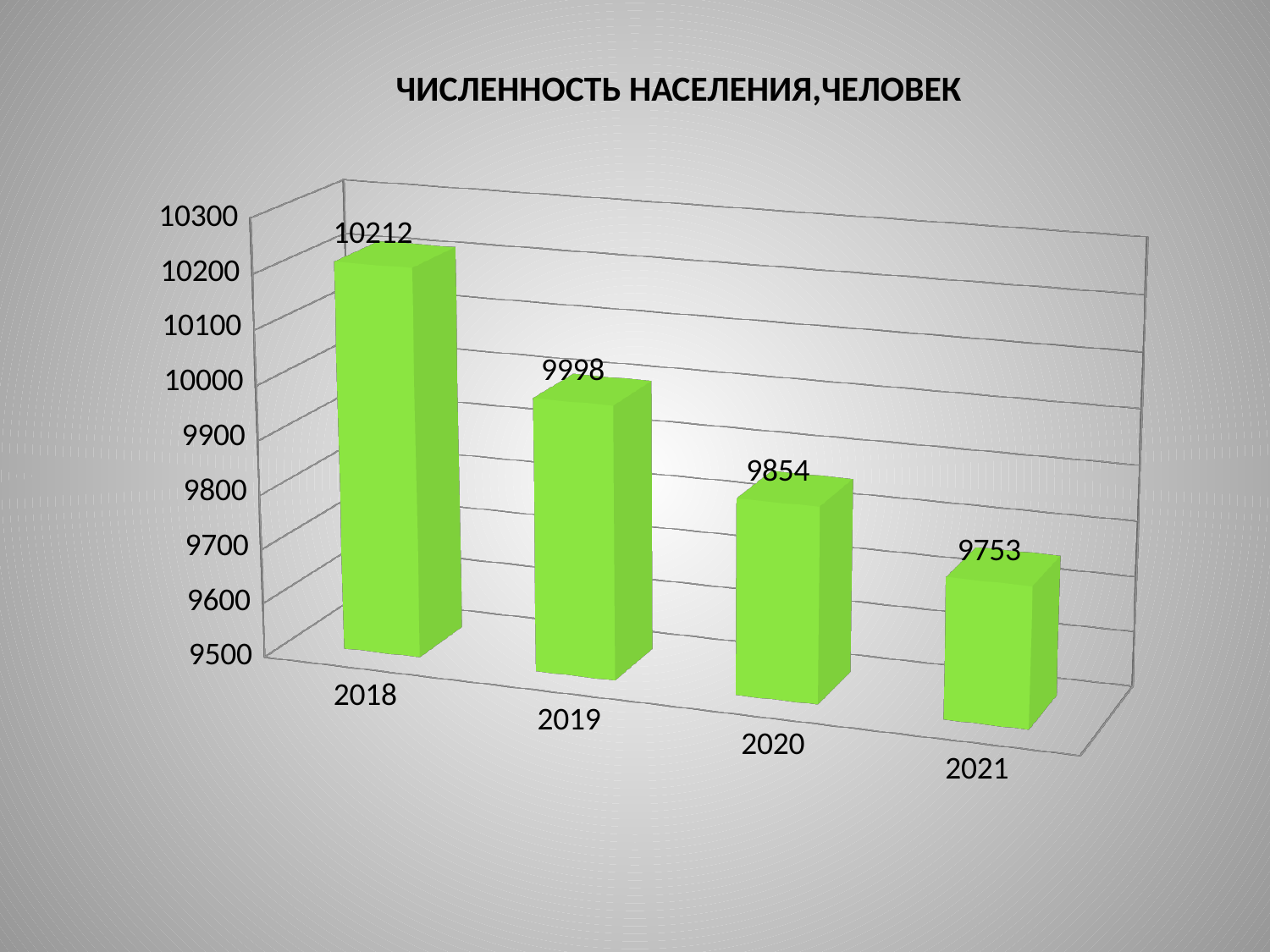
What is the population value shown for 2021? 9753 What kind of chart is this? bar chart Is the value for 2019 greater or less than 10000? less What is the difference between the population in 2020 and in 2021? 101 Which year has the lowest population? 2021 What is the difference between the population in 2018 and in 2019? 214 Which is larger, the population in 2019 or in 2020? 2019 What is the population value shown for 2018? 10212 What is the population value shown for 2020? 9854 Which year has the highest population? 2018 How many years are shown on the chart? 4 Do the values rise or fall from 2018 to 2021? fall